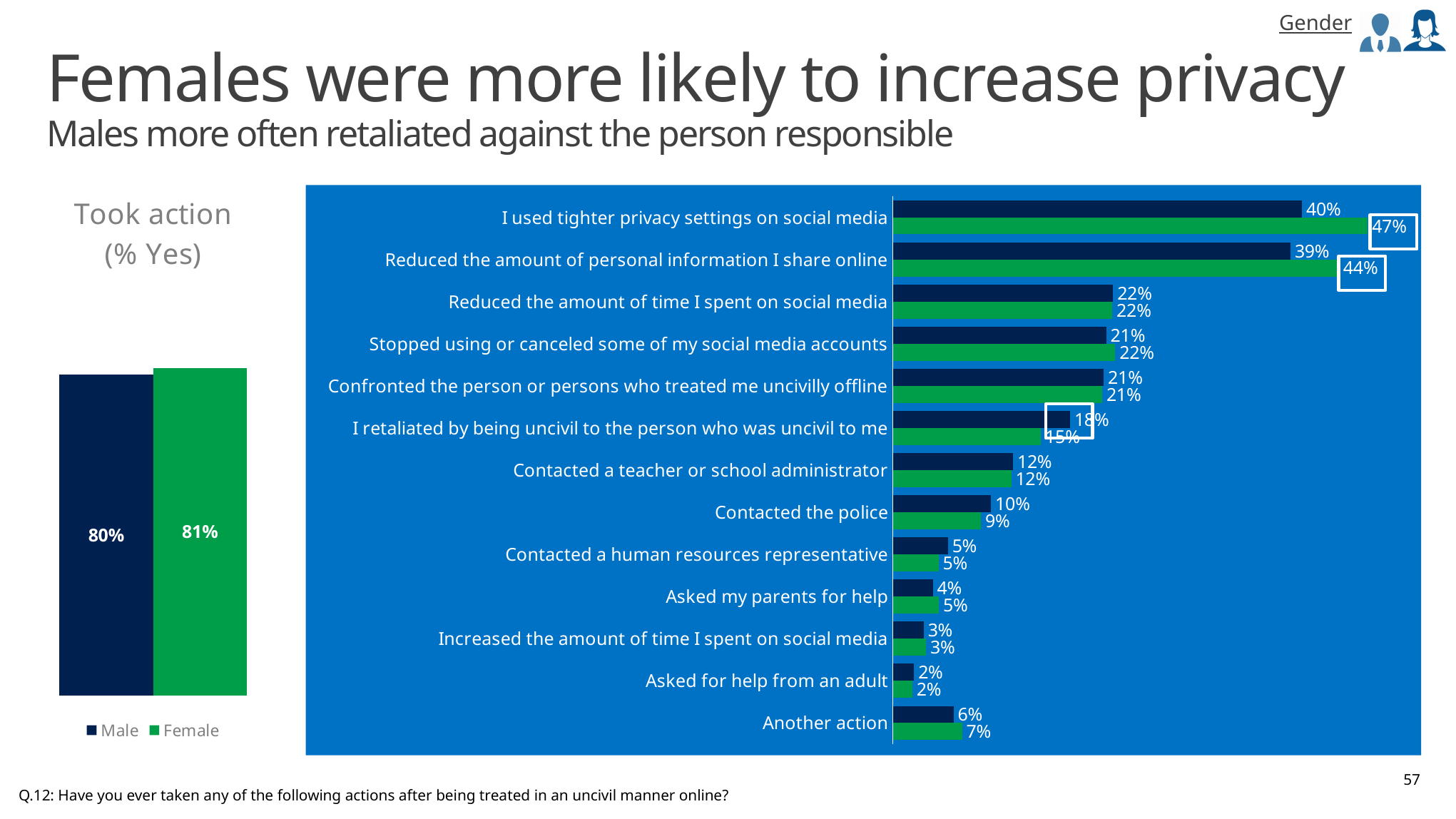
How many series does the legend on the slide list? 2 In the chart on the right, which action has the highest Female value? I used tighter privacy settings on social media In the 'Took action (% Yes)' chart on the left, what kind of chart is it? Bar chart In the chart on the right, which action has the lowest Male value? Asked for help from an adult How many actions are listed in the chart on the right? 13 In the chart on the right, what is the Male value for 'Reduced the amount of personal information I share online'? 39% In the chart on the right, which is larger for 'Contacted the police', the Male value or the Female value? Male In the chart on the right, what is the Male value for 'I retaliated by being uncivil to the person who was uncivil to me'? 18% In the chart on the right, what is the difference between the Female and Male values for 'I used tighter privacy settings on social media'? 7% In the 'Took action (% Yes)' chart on the left, what is the value for Female? 81% In the 'Took action (% Yes)' chart on the left, what is the value for Male? 80% In the chart on the right, what is the Female value for 'I used tighter privacy settings on social media'? 47%